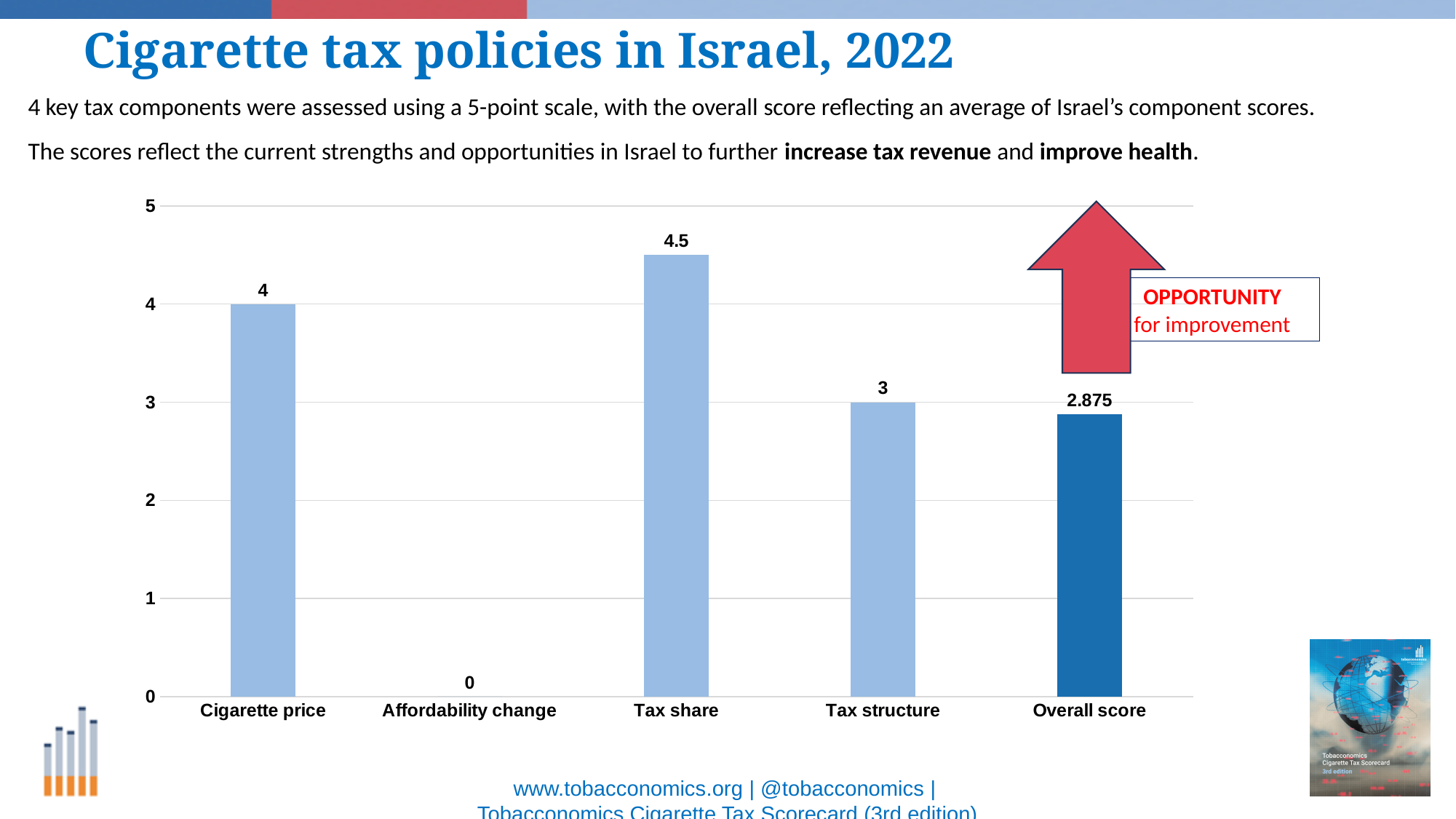
What is the maximum value shown on the y axis? 5 Which category has the highest value? Tax share Is the value for Overall score greater or less than 3? less What is the difference between the values for Tax share and Tax structure? 1.5 What is the value for Affordability change? 0 How many categories are shown on the x axis? 5 What is the value for Cigarette price? 4 What kind of chart is shown on the slide? bar chart Which is larger, the value for Cigarette price or the value for Tax structure? Cigarette price Which category has the lowest value? Affordability change What is the value for Tax share? 4.5 What is the value for Overall score? 2.875